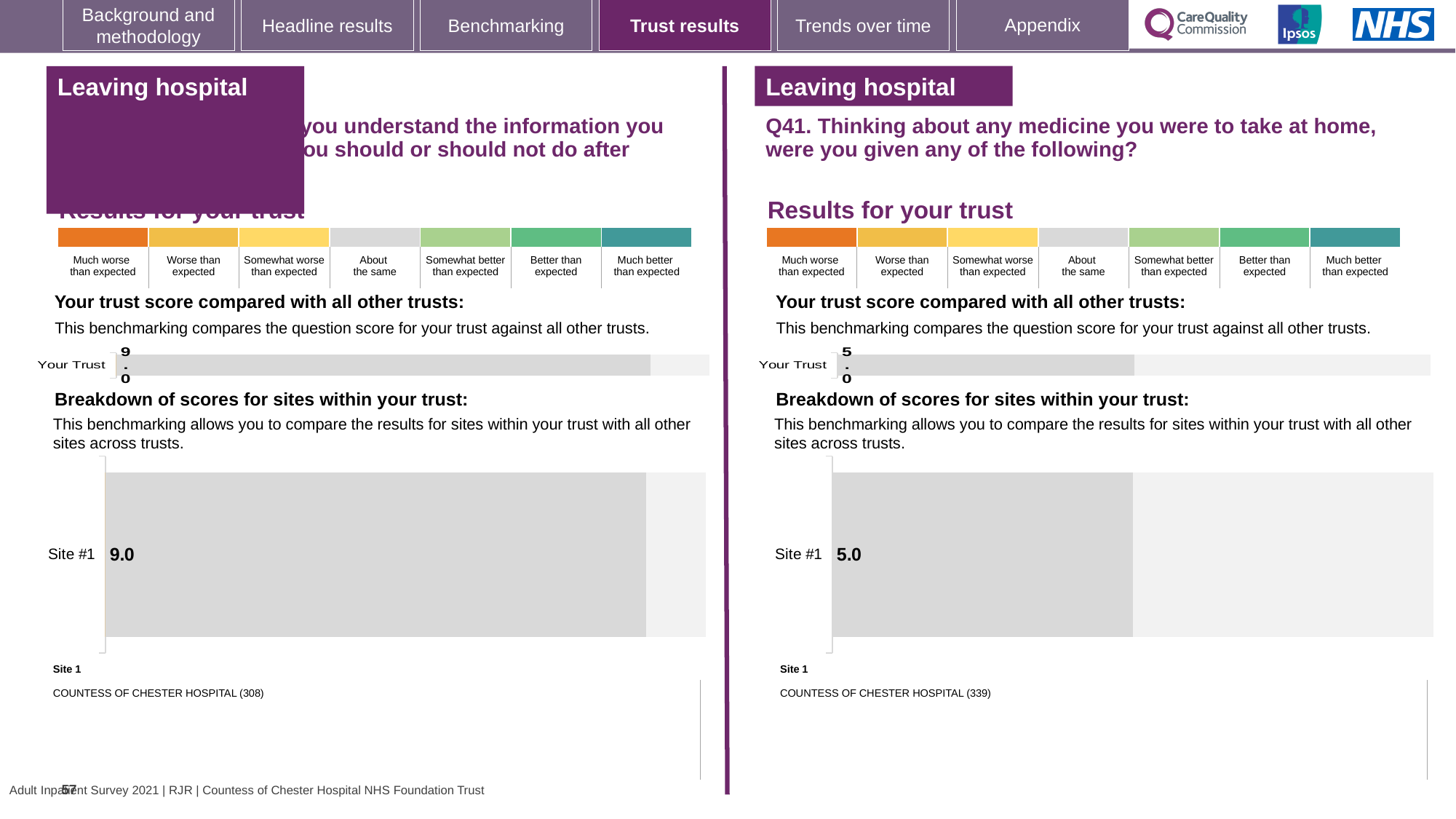
On the right-hand chart for Q41, what is the score shown for Your Trust? 5.0 Which Site #1 score is larger: the one on the left-hand chart or the one on the right-hand chart for Q41? The left-hand chart On the left-hand site breakdown chart, what is the score for Site #1? 9.0 What is the difference between the Site #1 score on the left-hand chart and the Site #1 score on the right-hand chart for Q41? 4.0 How many sites are shown in the site breakdown chart on the right-hand side of the slide? 1 On the right-hand chart for Q41, which hospital is listed as Site 1? COUNTESS OF CHESTER HOSPITAL On the left-hand chart, what is the score shown for Your Trust? 9.0 On the right-hand site breakdown chart for Q41, what is the score for Site #1? 5.0 How many rating categories are shown in the colour scale above the right-hand chart for Q41? 7 What kind of chart is used to show the Site #1 score on the right-hand side of the slide? Bar chart